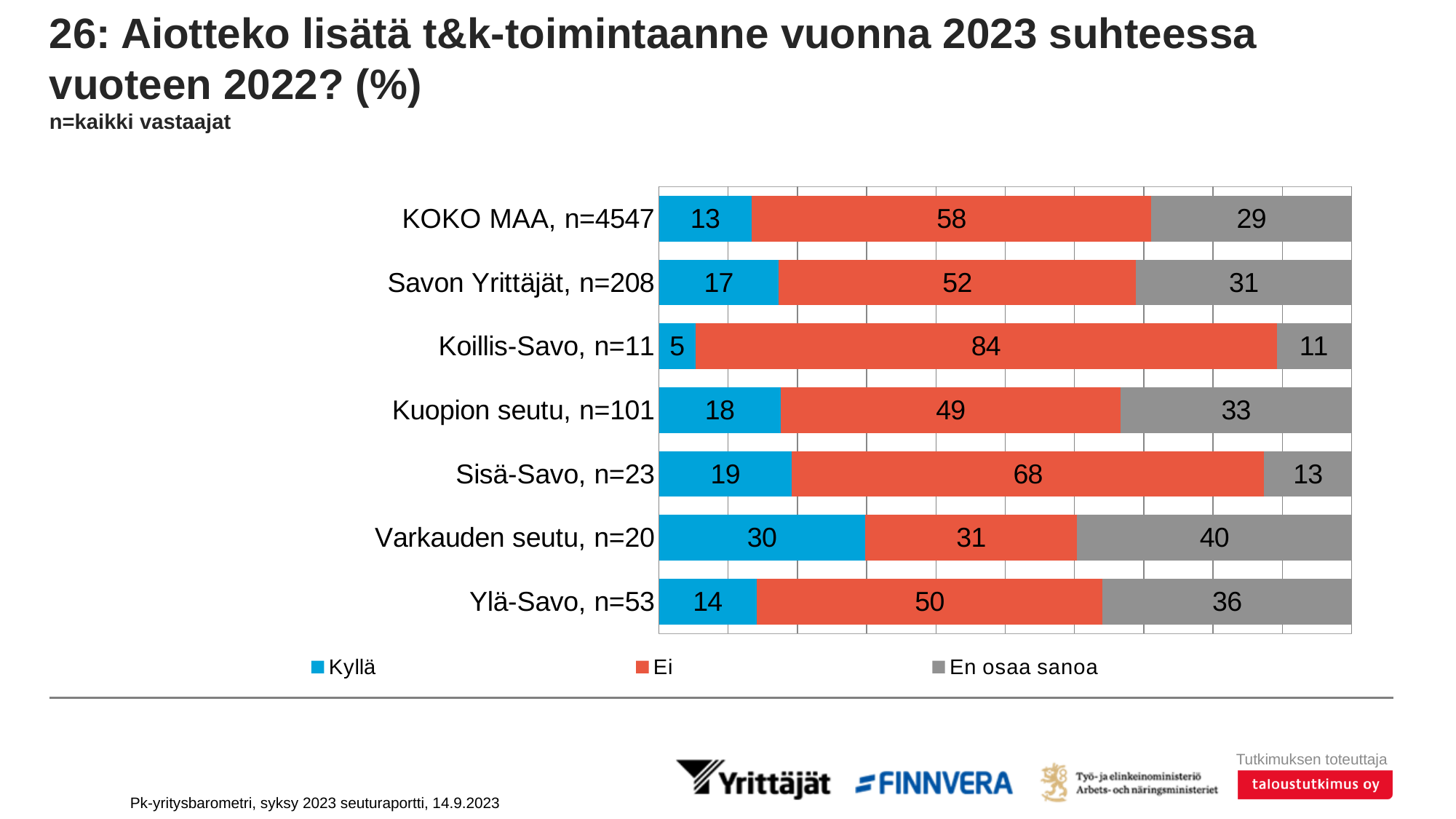
What is the "En osaa sanoa" value for Ylä-Savo, n=53? 36 What is the total of the stacked bar for Varkauden seutu, n=20? 101 What kind of chart is shown on the slide? Stacked bar chart Which series is shown in grey? En osaa sanoa Which category has the highest "Ei" value? Koillis-Savo, n=11 How many series does the legend list? 3 Which category has the lowest "Kyllä" value? Koillis-Savo, n=11 What is the difference between the "Ei" values for KOKO MAA, n=4547 and Savon Yrittäjät, n=208? 6 Which is larger: the "En osaa sanoa" value for Kuopion seutu, n=101 or for Sisä-Savo, n=23? Kuopion seutu, n=101 How many categories are shown on the chart? 7 What is the "Ei" value for Koillis-Savo, n=11? 84 What is the "Kyllä" value for Varkauden seutu, n=20? 30